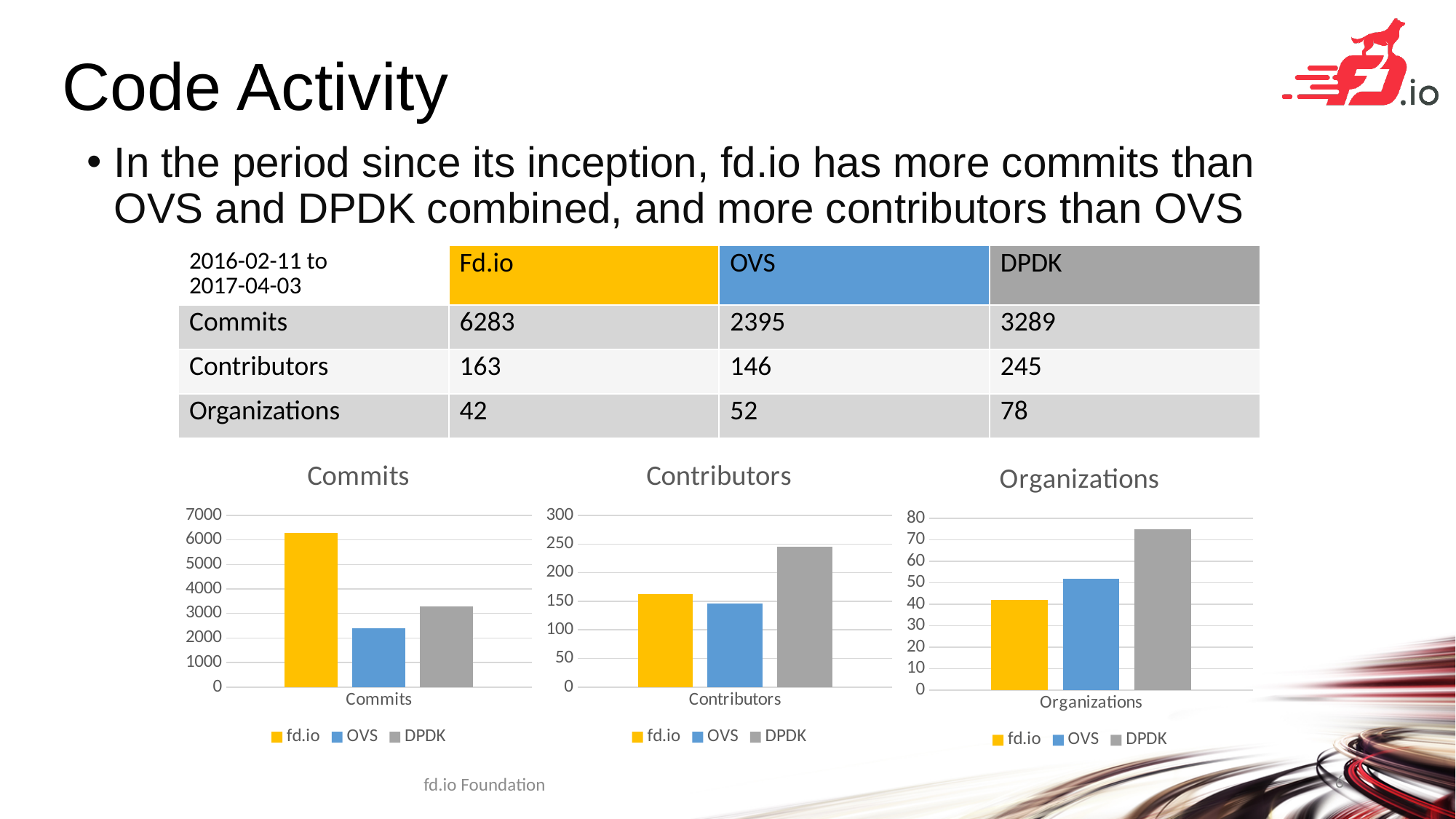
In the Commits chart, which series has the highest value? fd.io In the Contributors chart, which series has the highest value? DPDK What kind of chart is the Contributors chart? bar chart In the Organizations chart, is the value for OVS greater or less than 50? greater In the Contributors chart, what is the difference between the DPDK and fd.io values? 82 How many series does the legend of the Commits chart list? 3 In the Organizations chart, which is larger, the value for DPDK or the value for OVS? DPDK In the Contributors chart, what is the value for OVS? 146 In the Commits chart, is the value for DPDK greater or less than 3000? greater In the Commits chart, which series has the lowest value? OVS In the Commits chart, what is the value for fd.io? 6283 In the Organizations chart, which series has the lowest value? fd.io